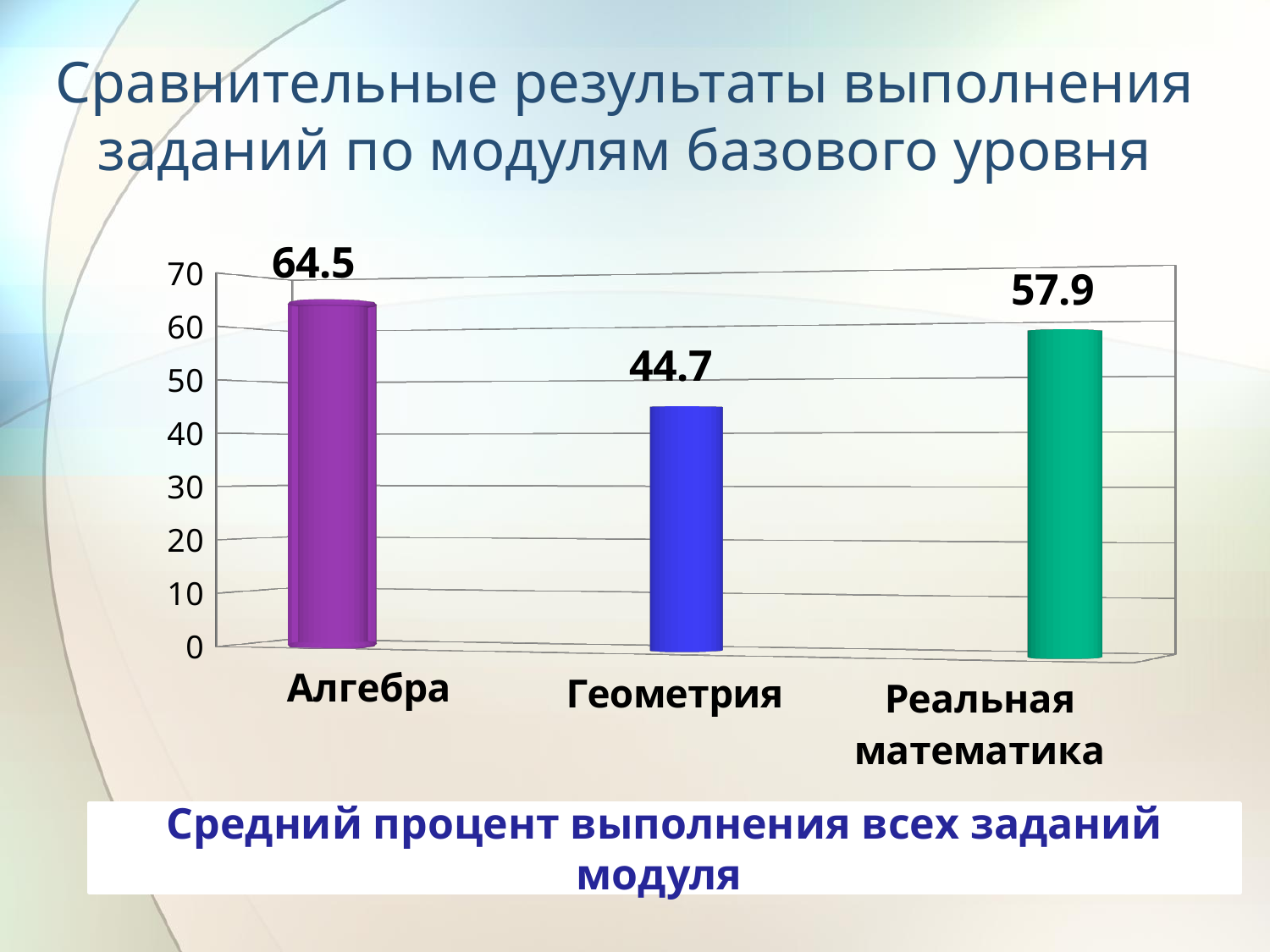
What colour is the bar for Геометрия? blue How many categories are shown in the chart? 3 What is the value for Реальная математика? 57.9 What is the value for Алгебра? 64.5 Which category has the lowest value? Геометрия Is the value for Геометрия greater or less than 50? less Which is larger, the value for Реальная математика or the value for Геометрия? Реальная математика What kind of chart is shown on the slide? bar chart What is the difference between the values for Алгебра and Реальная математика? 6.6 What is the value for Геометрия? 44.7 What is the difference between the values for Алгебра and Геометрия? 19.8 Which category has the highest value? Алгебра